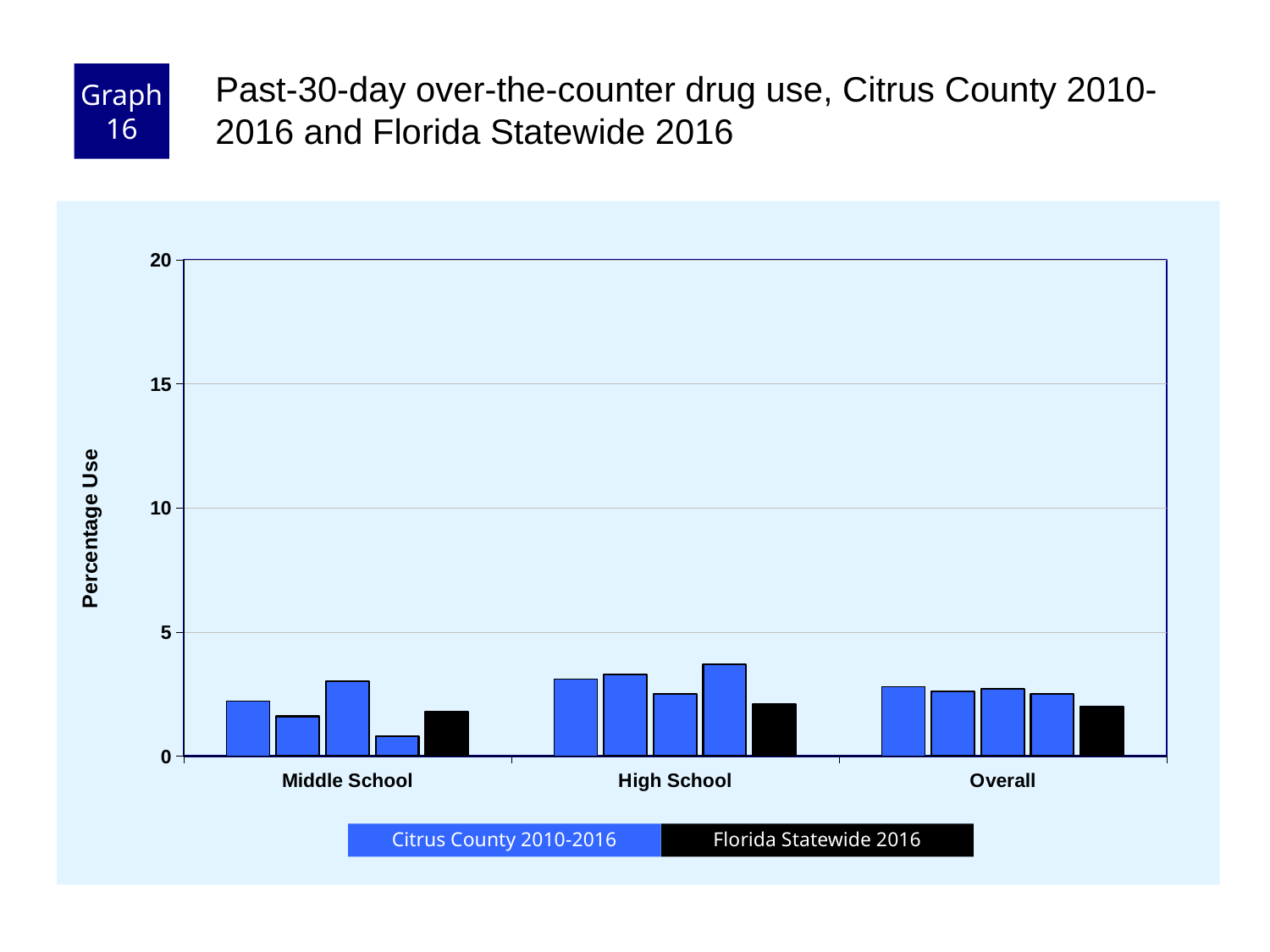
Which series is shown in black? Florida Statewide 2016 Is the tallest Citrus County bar for High School greater or less than 5? less Which category contains the tallest bar on the chart? High School Is the Florida Statewide 2016 value for Overall greater or less than 5? less For Middle School, which is larger: the fourth Citrus County bar or the Florida Statewide 2016 bar? Florida Statewide 2016 How many categories are shown on the x axis? 3 Is the Florida Statewide 2016 value for High School greater or less than 5? less Which category has the lowest single bar on the chart? Middle School How many series does the legend list? 2 What is the label on the y axis? Percentage Use What kind of chart is shown on the slide? bar chart